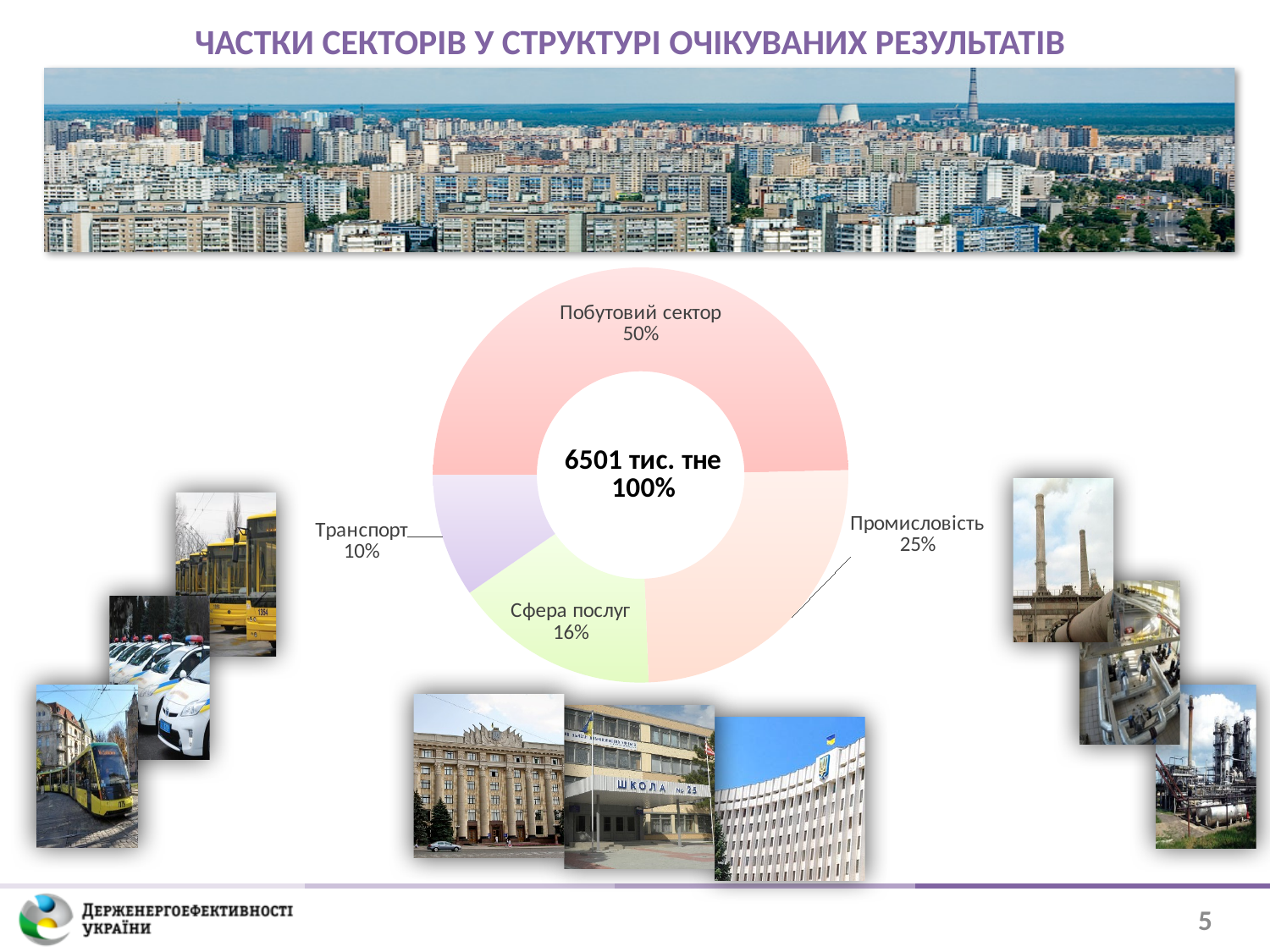
What is the title of the slide containing the chart? ЧАСТКИ СЕКТОРІВ У СТРУКТУРІ ОЧІКУВАНИХ РЕЗУЛЬТАТІВ Which is larger, the share of Сфера послуг or the share of Транспорт? Сфера послуг How many sectors are shown in the chart? 4 What share of the chart does Промисловість have? 25% What share of the chart does Побутовий сектор have? 50% What share of the chart does Сфера послуг have? 16% Which sector has the smallest share in the chart? Транспорт What share of the chart does Транспорт have? 10% What total value is printed in the centre of the chart? 6501 тис. тне What kind of chart is shown on the slide? Doughnut (pie) chart Which sector has the largest share in the chart? Побутовий сектор What is the difference in percentage points between Побутовий сектор and Промисловість? 25